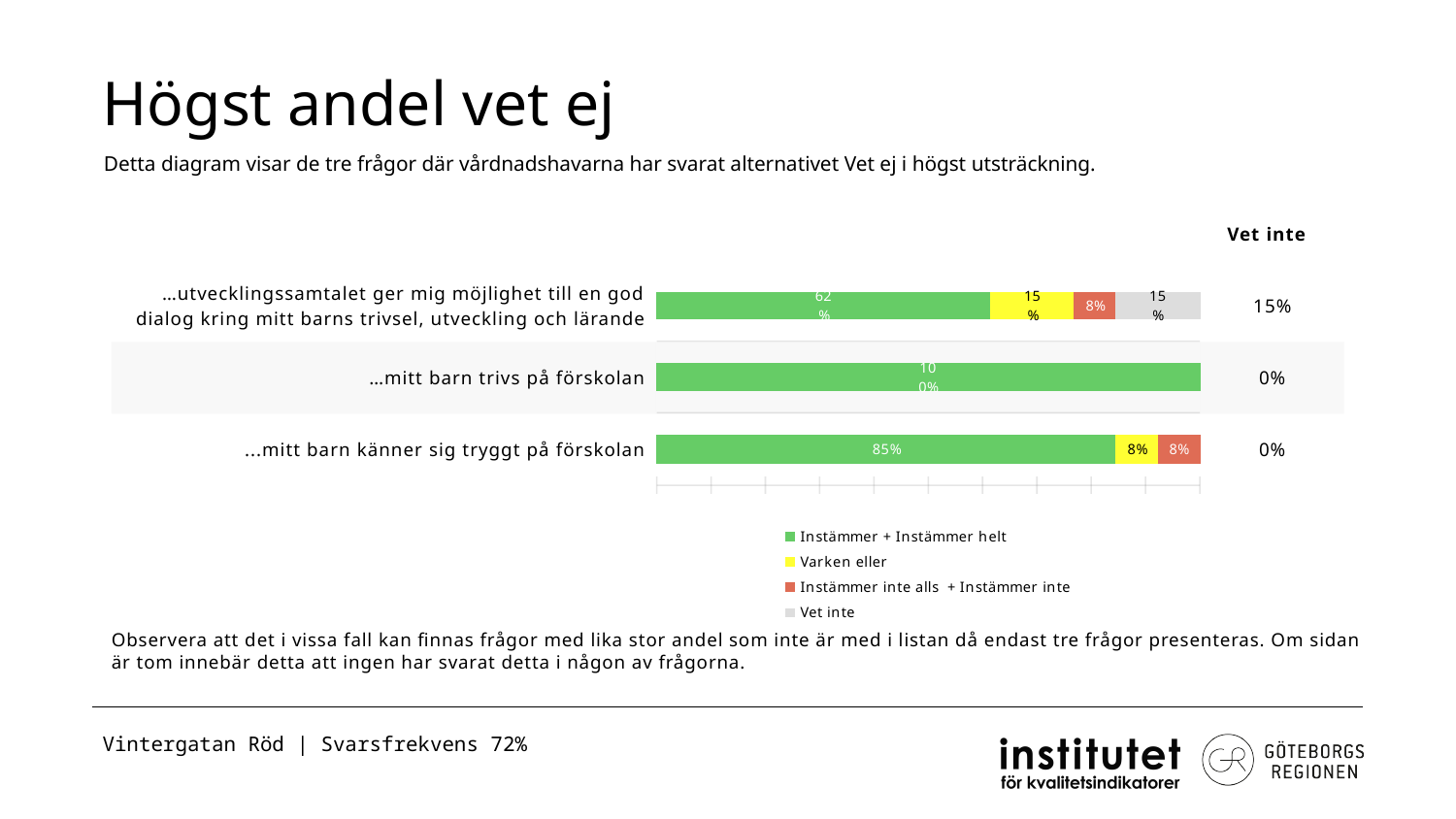
How many categories (questions) are plotted in the chart? 3 What kind of chart is shown on the slide? bar chart What is the 'Instämmer + Instämmer helt' value for '…mitt barn känner sig tryggt på förskolan'? 85% What is the difference between the 'Instämmer + Instämmer helt' values for '…mitt barn känner sig tryggt på förskolan' and '…utvecklingssamtalet ger mig möjlighet till en god dialog kring mitt barns trivsel, utveckling och lärande'? 23% Which category has the highest 'Instämmer + Instämmer helt' value? …mitt barn trivs på förskolan What is the 'Vet inte' value shown for '…utvecklingssamtalet ger mig möjlighet till en god dialog kring mitt barns trivsel, utveckling och lärande'? 15% Which category has the lowest 'Instämmer + Instämmer helt' value? …utvecklingssamtalet ger mig möjlighet till en god dialog kring mitt barns trivsel, utveckling och lärande What is the 'Instämmer + Instämmer helt' value for '…utvecklingssamtalet ger mig möjlighet till en god dialog kring mitt barns trivsel, utveckling och lärande'? 62% What is the 'Vet inte' value shown for '…mitt barn trivs på förskolan'? 0% What is the title of the slide containing the chart? Högst andel vet ej What is the 'Varken eller' value for '…mitt barn känner sig tryggt på förskolan'? 8% How many series does the legend list? 4